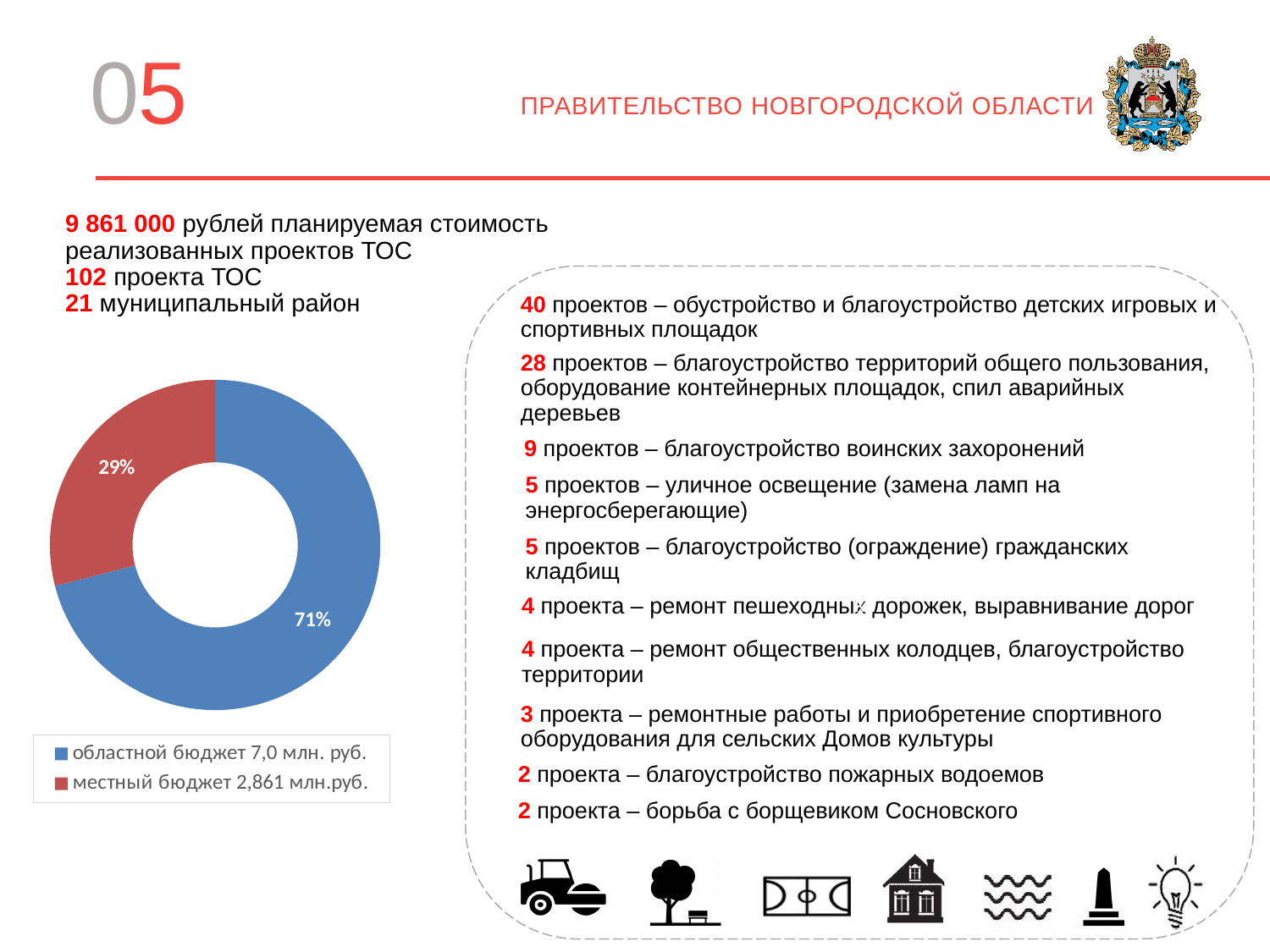
How many entries does the chart legend list? 2 Which slice of the chart is the largest? областной бюджет 7,0 млн. руб. Which is larger: the share for областной бюджет or the share for местный бюджет? областной бюджет What kind of chart is shown on the slide? doughnut (pie) chart What colour is the slice for "областной бюджет 7,0 млн. руб."? blue How many slices does the chart have? 2 Is the share for местный бюджет greater or less than 50%? less What is the difference in percentage points between the областной бюджет slice and the местный бюджет slice? 42 Which slice of the chart is the smallest? местный бюджет 2,861 млн.руб. What colour is the slice for "местный бюджет 2,861 млн.руб."? red What share of the chart does "областной бюджет 7,0 млн. руб." represent? 71% What share of the chart does "местный бюджет 2,861 млн.руб." represent? 29%